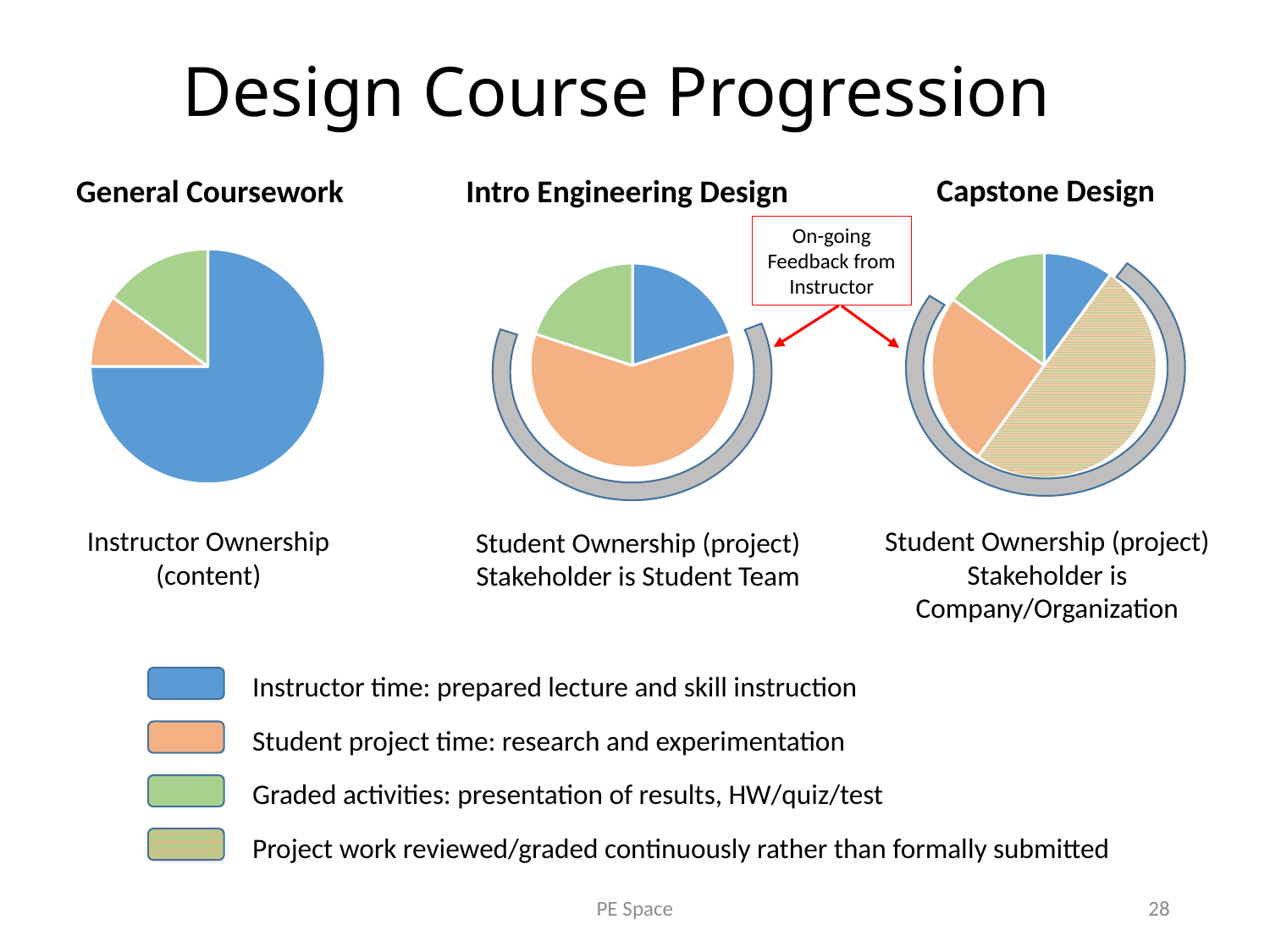
In the Capstone Design pie chart, which category takes the largest share? Project work reviewed/graded continuously rather than formally submitted How many slices does the Capstone Design pie chart have? 4 In the General Coursework pie chart, which category takes the largest share? Instructor time: prepared lecture and skill instruction How many entries does the legend at the bottom of the slide list? 4 In the Capstone Design pie chart, which category takes the smallest share? Instructor time: prepared lecture and skill instruction Which colour represents Student project time in the pie charts? orange In the Intro Engineering Design pie chart, which category takes the largest share? Student project time: research and experimentation In the Capstone Design pie chart, is the share for Student project time larger or smaller than the share for Instructor time? larger In the General Coursework pie chart, is the share for Instructor time larger or smaller than the share for Graded activities? larger How many slices does the General Coursework pie chart have? 3 What kind of chart is used for General Coursework? pie chart How many slices does the Intro Engineering Design pie chart have? 3